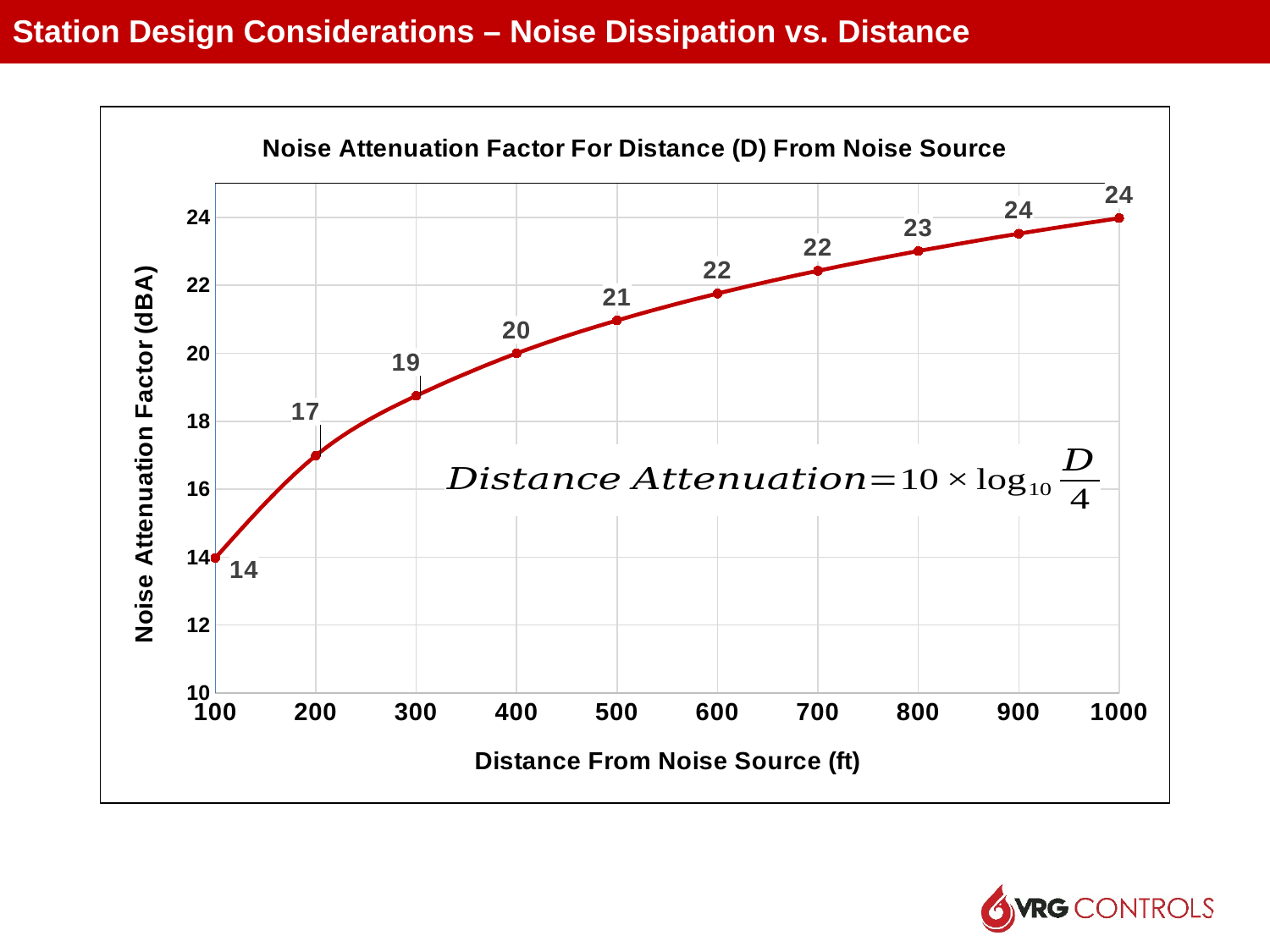
At which distance is the noise attenuation factor lowest? 100 ft What is the noise attenuation factor at a distance of 1000 ft? 24 What kind of chart is shown on the slide? Line chart What is the noise attenuation factor at a distance of 400 ft? 20 What is the difference between the noise attenuation factor at 1000 ft and at 100 ft? 10 Which has a higher noise attenuation factor: 300 ft or 600 ft? 600 ft What is the noise attenuation factor at a distance of 100 ft? 14 Does the noise attenuation factor rise or fall as distance from the noise source increases? Rises How many data points are plotted on the chart? 10 Is the noise attenuation factor at 200 ft greater or less than 16? greater What is the noise attenuation factor at a distance of 800 ft? 23 What is the title of the chart? Noise Attenuation Factor For Distance (D) From Noise Source